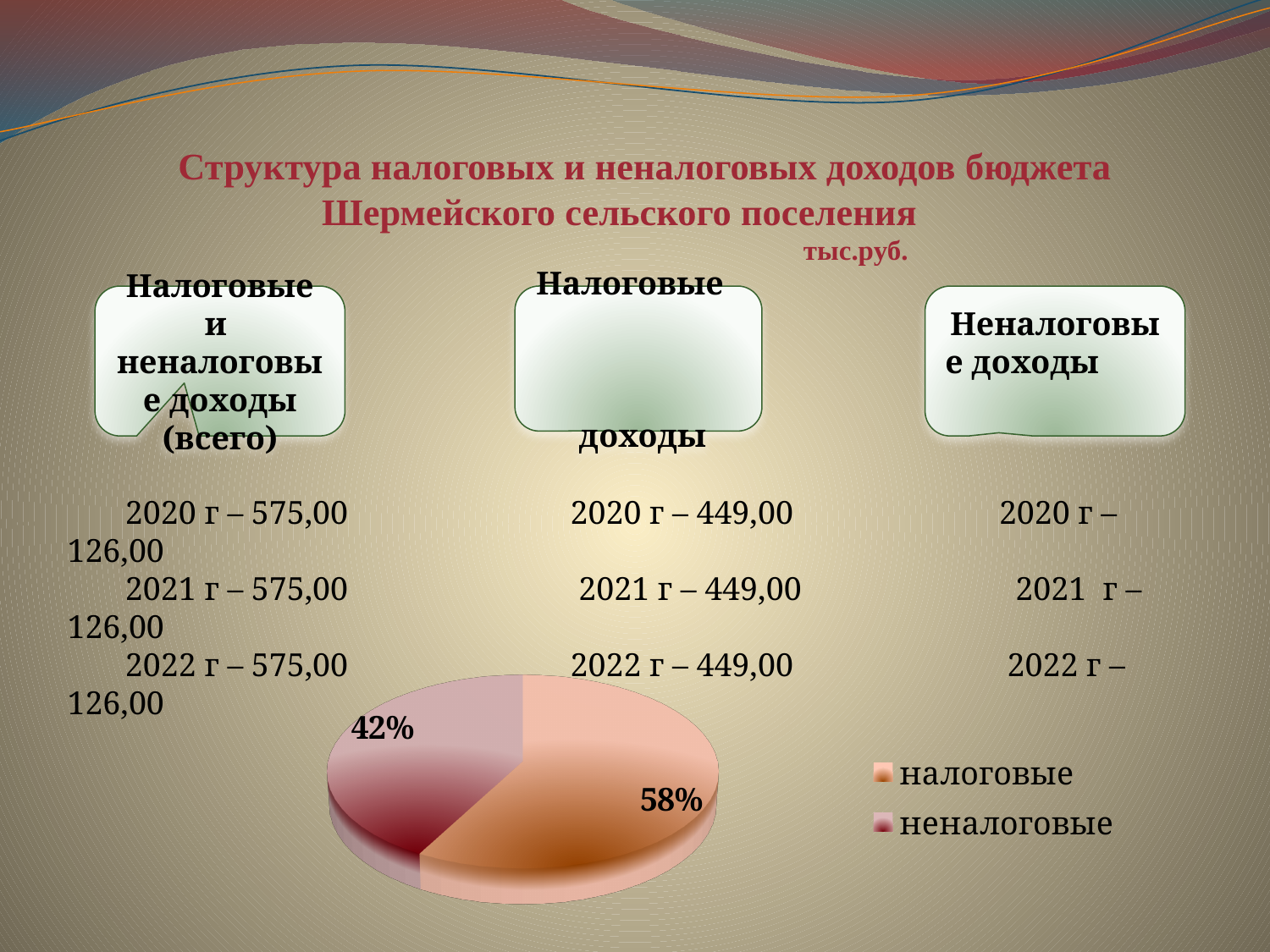
How many slices does the pie chart have? 2 What is the difference in percentage points between the "налоговые" and "неналоговые" slices? 16% What share of the pie does the "налоговые" slice represent? 58% Which legend entry is shown in the darker red/pink colour? неналоговые How many entries does the legend of the pie chart list? 2 What kind of chart is shown on the slide? Pie chart Which slice of the pie chart is the largest? налоговые Is the share of the "неналоговые" slice greater or less than 50%? less Which is larger in the pie chart, "налоговые" or "неналоговые"? налоговые Which slice of the pie chart is the smallest? неналоговые What share of the pie does the "неналоговые" slice represent? 42% What are the two legend entries of the pie chart? налоговые, неналоговые